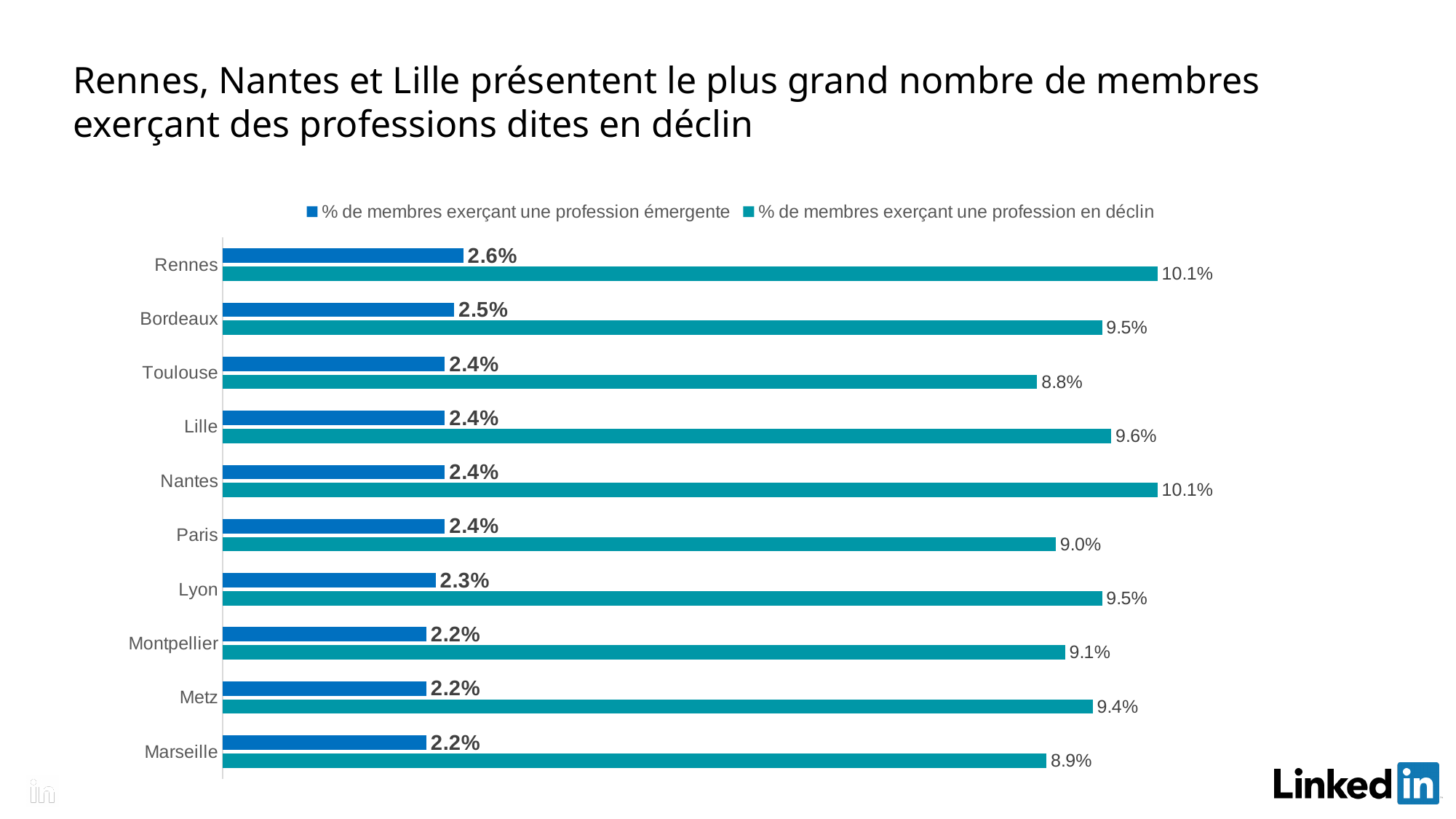
What is the value for Toulouse in the '% de membres exerçant une profession en déclin' series? 8.8% How many cities are shown on the chart? 10 What is the difference between the '% de membres exerçant une profession en déclin' values for Rennes and Marseille? 1.2% What is the value for Metz in the '% de membres exerçant une profession en déclin' series? 9.4% How many series does the legend list? 2 Which city has the highest value in the '% de membres exerçant une profession émergente' series? Rennes Which is larger: the '% de membres exerçant une profession en déclin' value for Lille or for Paris? Lille Which city is listed at the bottom of the chart? Marseille Which city has the lowest value in the '% de membres exerçant une profession en déclin' series? Toulouse What kind of chart is shown on the slide? Bar chart What is the value for Rennes in the '% de membres exerçant une profession émergente' series? 2.6% What is the difference between the '% de membres exerçant une profession émergente' values for Rennes and Lyon? 0.3%